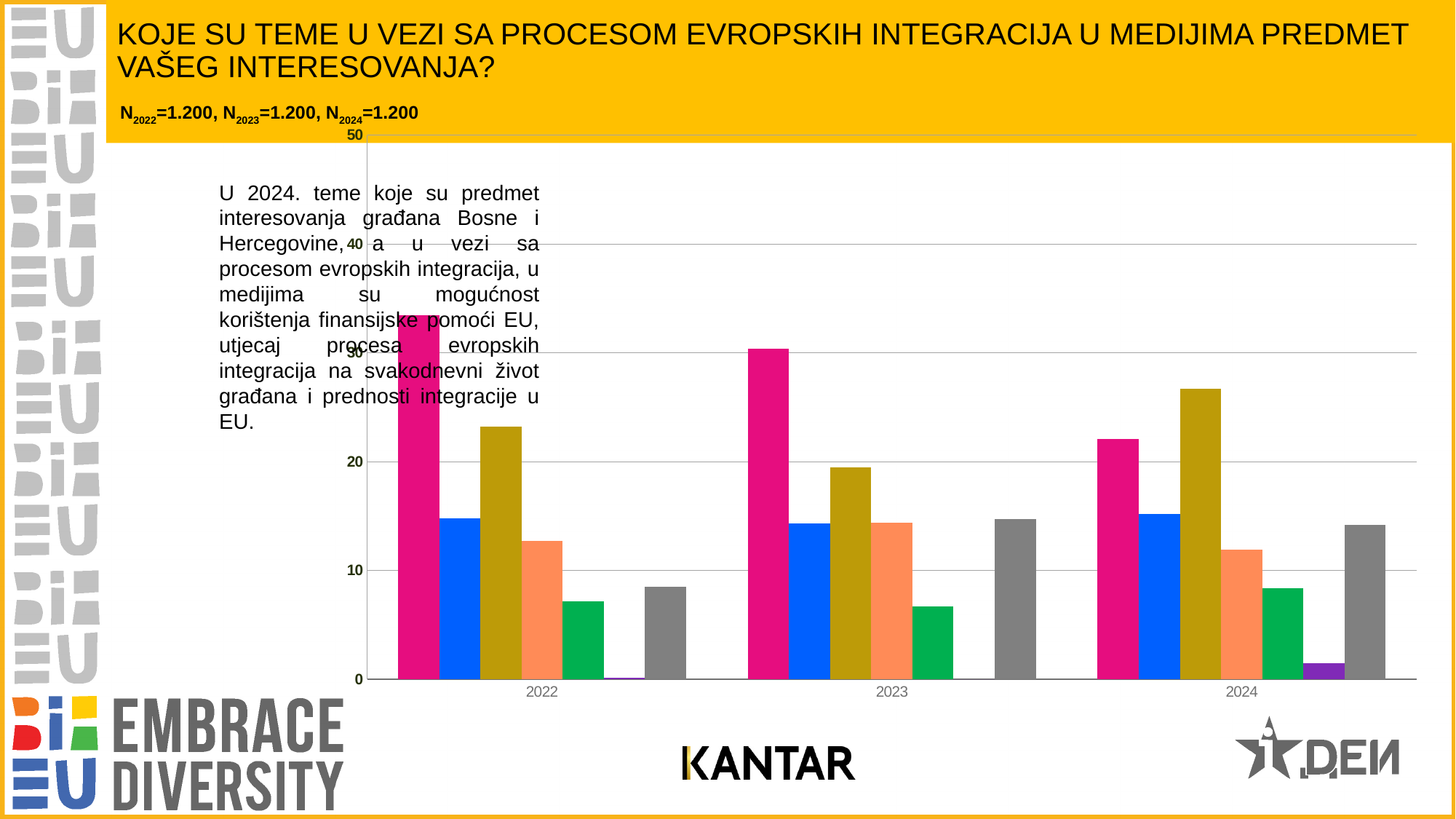
In 2022, which is larger: the pink bar or the gold bar? the pink bar What is the highest value shown on the y axis of the chart? 50 What kind of chart is shown on the slide? bar chart Is the value of the pink bar for 2022 greater or less than 30? greater How many year categories are shown on the x axis of the chart? 3 Is the value of the green bar for 2023 greater or less than 10? less In which year is the pink bar the tallest? 2022 Is the value of the gray bar for 2022 greater or less than 10? less How many bars are plotted in the 2024 group? 7 In 2024, which is larger: the pink bar or the gold bar? the gold bar Does the pink bar rise or fall from 2022 to 2024? fall